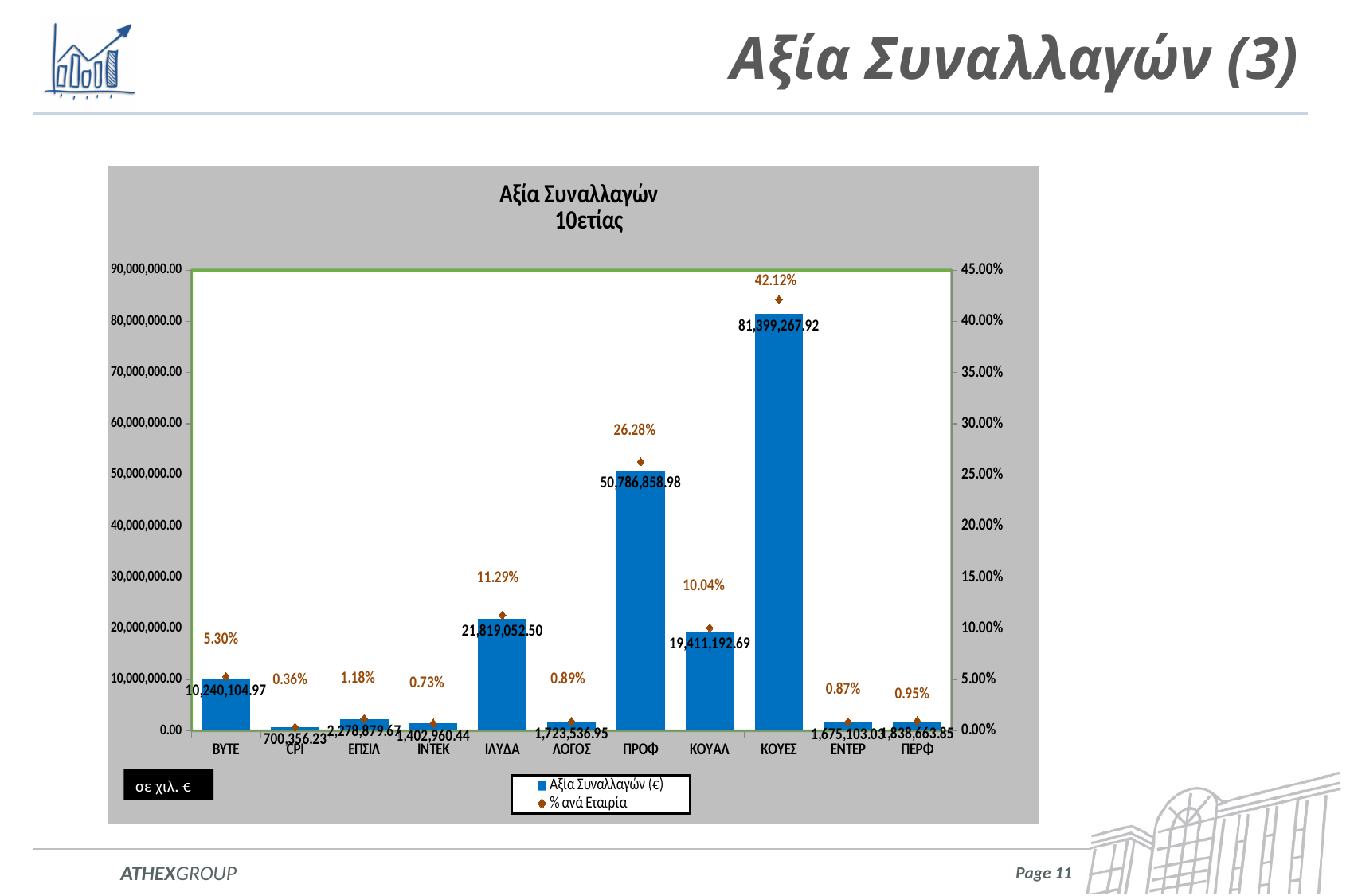
What is the title of the chart? Αξία Συναλλαγών 10ετίας Which company has the lowest % ανά Εταιρία? CPI How many series does the legend list? 2 Is the Αξία Συναλλαγών (€) value for BYTE greater or less than 20,000,000.00? less What is the % ανά Εταιρία value for ΙΛΥΔΑ? 11.29% What is the difference in % ανά Εταιρία between ΚΟΥΕΣ and ΠΡΟΦ? 15.84% What is the % ανά Εταιρία value for CPI? 0.36% Which has a larger Αξία Συναλλαγών (€), ΙΛΥΔΑ or ΚΟΥΑΛ? ΙΛΥΔΑ How many companies are shown on the x axis? 11 What is the value of Αξία Συναλλαγών (€) for ΠΡΟΦ? 50,786,858.98 Which company has the highest Αξία Συναλλαγών (€)? ΚΟΥΕΣ What is the value of Αξία Συναλλαγών (€) for ΚΟΥΕΣ? 81,399,267.92